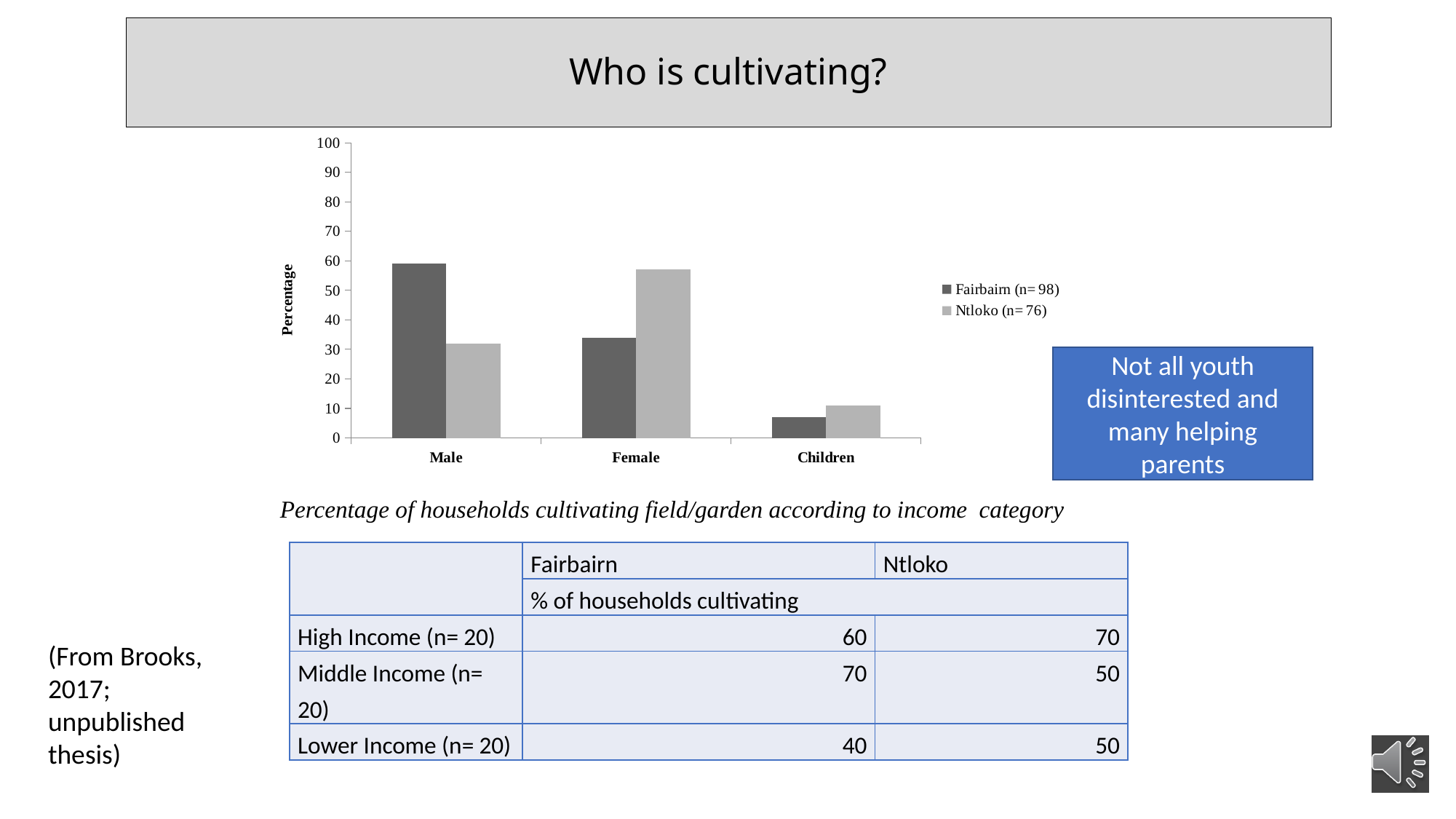
How many categories are shown on the x axis of the chart? 3 Is the value for Male in the Fairbairn (n= 98) series greater or less than 50? greater What kind of chart is shown on the slide? bar chart What is the label on the chart's vertical axis? Percentage Which category has the highest value for the Ntloko (n= 76) series? Female Is the value for Children in the Ntloko (n= 76) series greater or less than 20? less Which category has the highest value for the Fairbairn (n= 98) series? Male How many series does the chart's legend list? 2 Which category has the lowest value for the Ntloko (n= 76) series? Children Is the value for Female in the Fairbairn (n= 98) series greater or less than 40? less Which category has the lowest value for the Fairbairn (n= 98) series? Children For the Male category, which series has the larger value, Fairbairn (n= 98) or Ntloko (n= 76)? Fairbairn (n= 98)